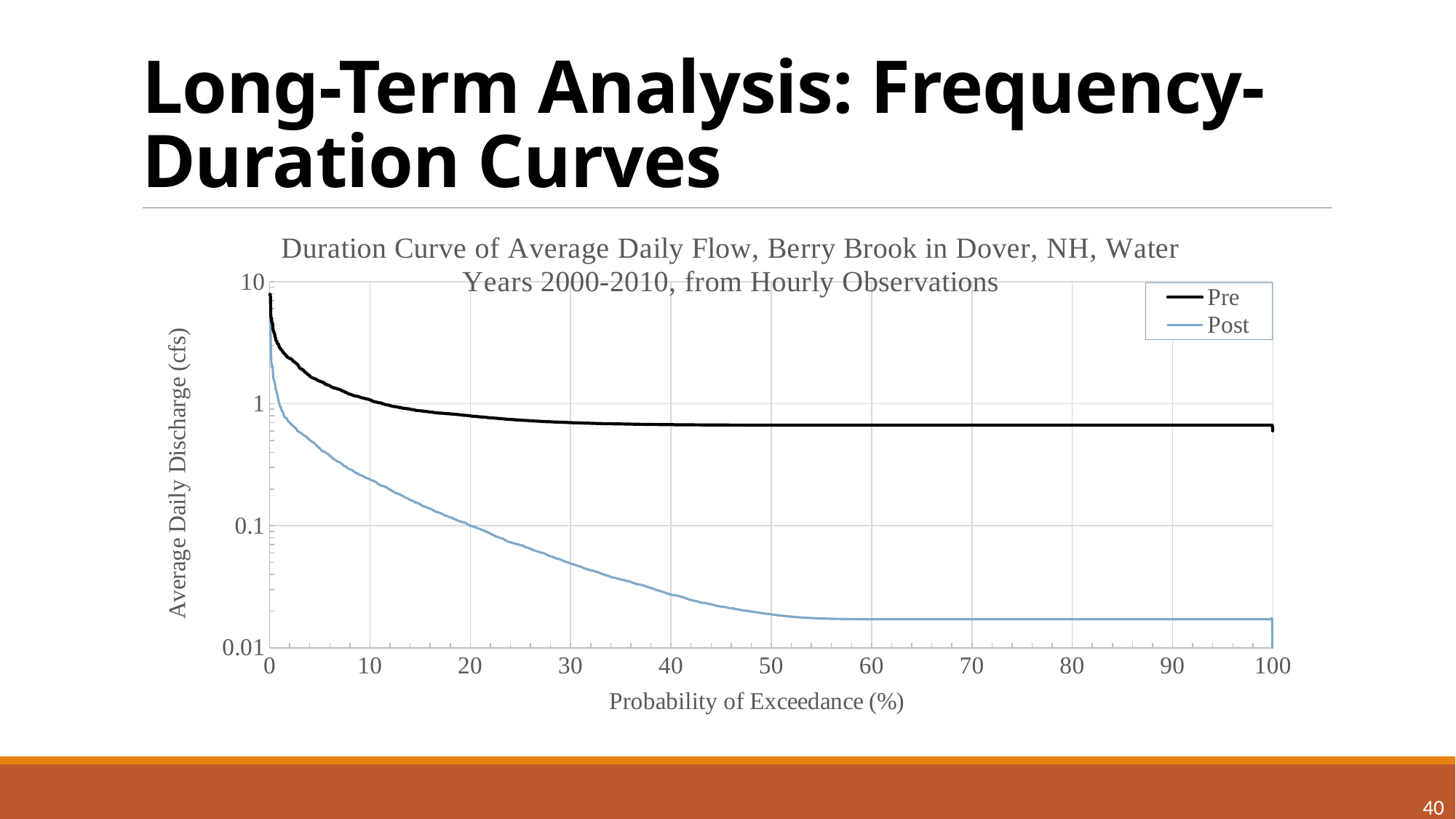
How many series does the legend list? 2 What kind of chart is shown on the slide? Line chart At 50% probability of exceedance, which series has the larger discharge, Pre or Post? Pre Is the Pre discharge at 90% probability of exceedance greater or less than 0.1 cfs? greater Is the Post discharge at 80% probability of exceedance greater or less than 0.01 cfs? greater What are the two series named in the legend? Pre and Post What is the label of the x axis? Probability of Exceedance (%) Is the Post discharge at 50% probability of exceedance greater or less than 0.1 cfs? less Do the values of the Pre curve rise or fall as probability of exceedance increases? Fall Do the values of the Post curve rise or fall as probability of exceedance increases? Fall